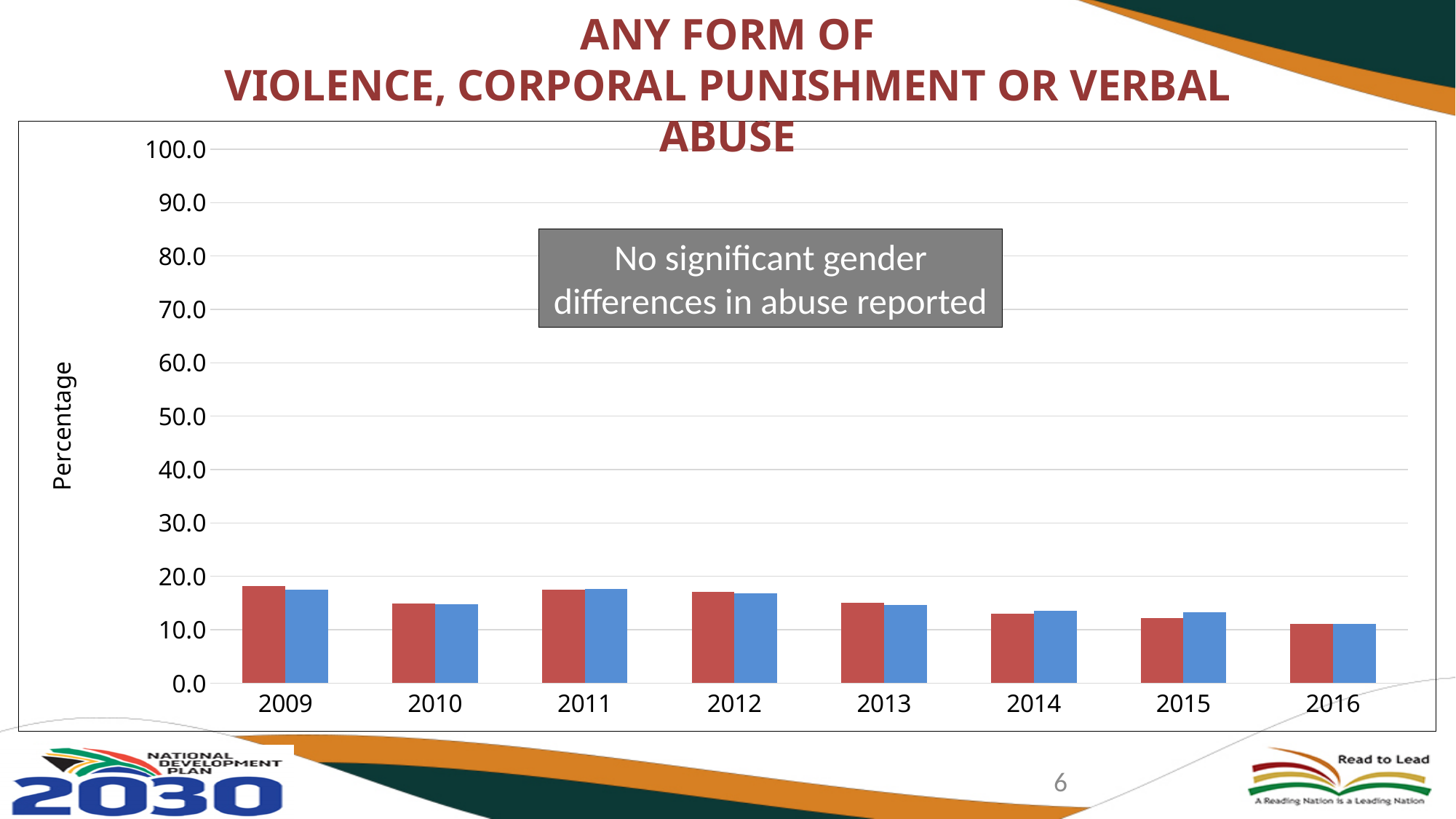
What kind of chart is shown on the slide? bar chart What does the text box inside the chart say? No significant gender differences in abuse reported Is the value of the red bar for 2009 greater or less than 20.0? less How many bars are plotted for each year in the chart? 2 What is the label on the vertical axis of the chart? Percentage Is the value of the red bar for 2009 greater or less than 10.0? greater Which year has the lowest bars in the chart? 2016 Is the value of the blue bar for 2013 greater or less than 20.0? less Which is larger, the red bar for 2009 or the red bar for 2016? 2009 Do the values in the chart generally rise or fall from 2009 to 2016? fall Which is larger, the blue bar for 2011 or the blue bar for 2014? 2011 How many years are shown on the x axis of the chart? 8